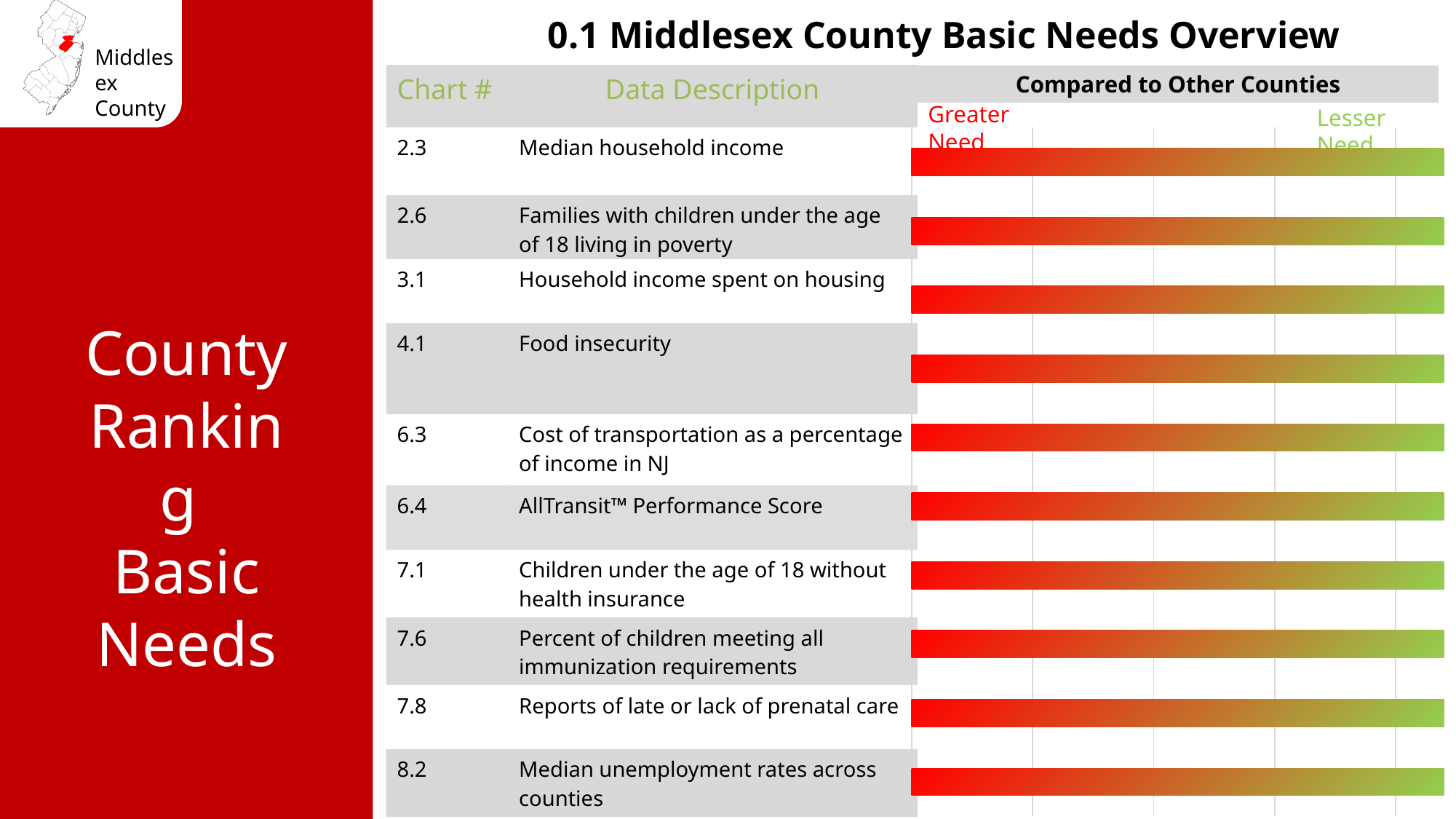
What kind of chart is shown on the slide? bar chart Which chart number corresponds to the bar labelled 'Food insecurity'? 4.1 What is the title of the chart on the slide? 0.1 Middlesex County Basic Needs Overview How many bars are plotted in the chart? 10 What label appears at the left end of the bar scale? Greater Need What data description is listed for chart number 7.8? Reports of late or lack of prenatal care